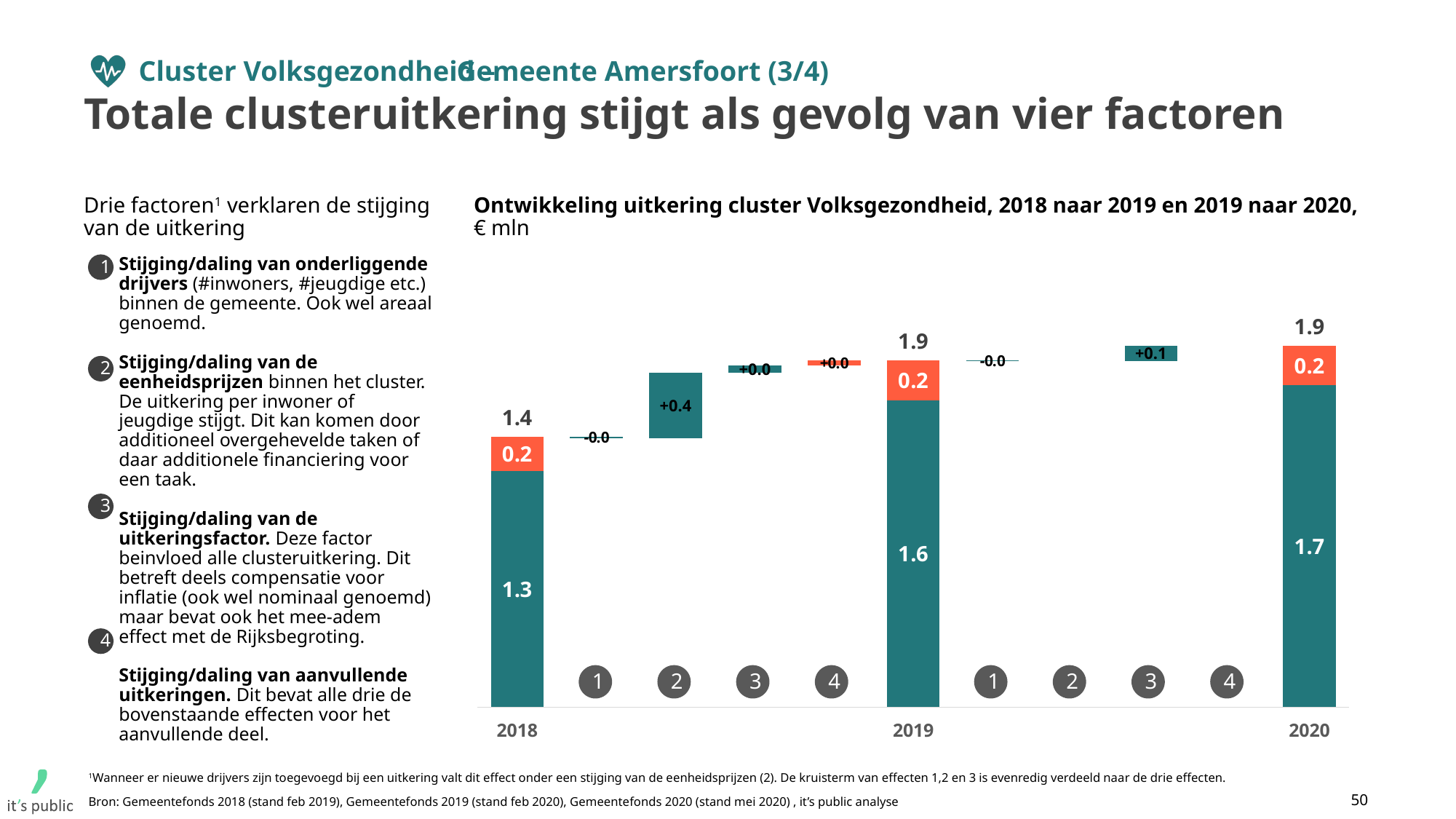
What is the effect of factor 2 between 2018 and 2019? +0.4 What kind of chart is shown on the slide? bar chart (waterfall) In which unit are the values in the chart expressed, according to the chart title? € mln By how much does the total uitkering increase from 2018 to 2019? 0.5 What value is printed in the teal (lower) segment of the 2020 bar? 1.7 What is the total uitkering for 2018 shown above the 2018 bar? 1.4 What value is printed in the teal (lower) segment of the 2018 bar? 1.3 What is the total uitkering for 2020 shown above the 2020 bar? 1.9 What is the effect of factor 3 between 2019 and 2020? +0.1 What is the total uitkering for 2019 shown above the 2019 bar? 1.9 Which factor has the largest effect between 2018 and 2019? 2 What value is printed in the teal (lower) segment of the 2019 bar? 1.6